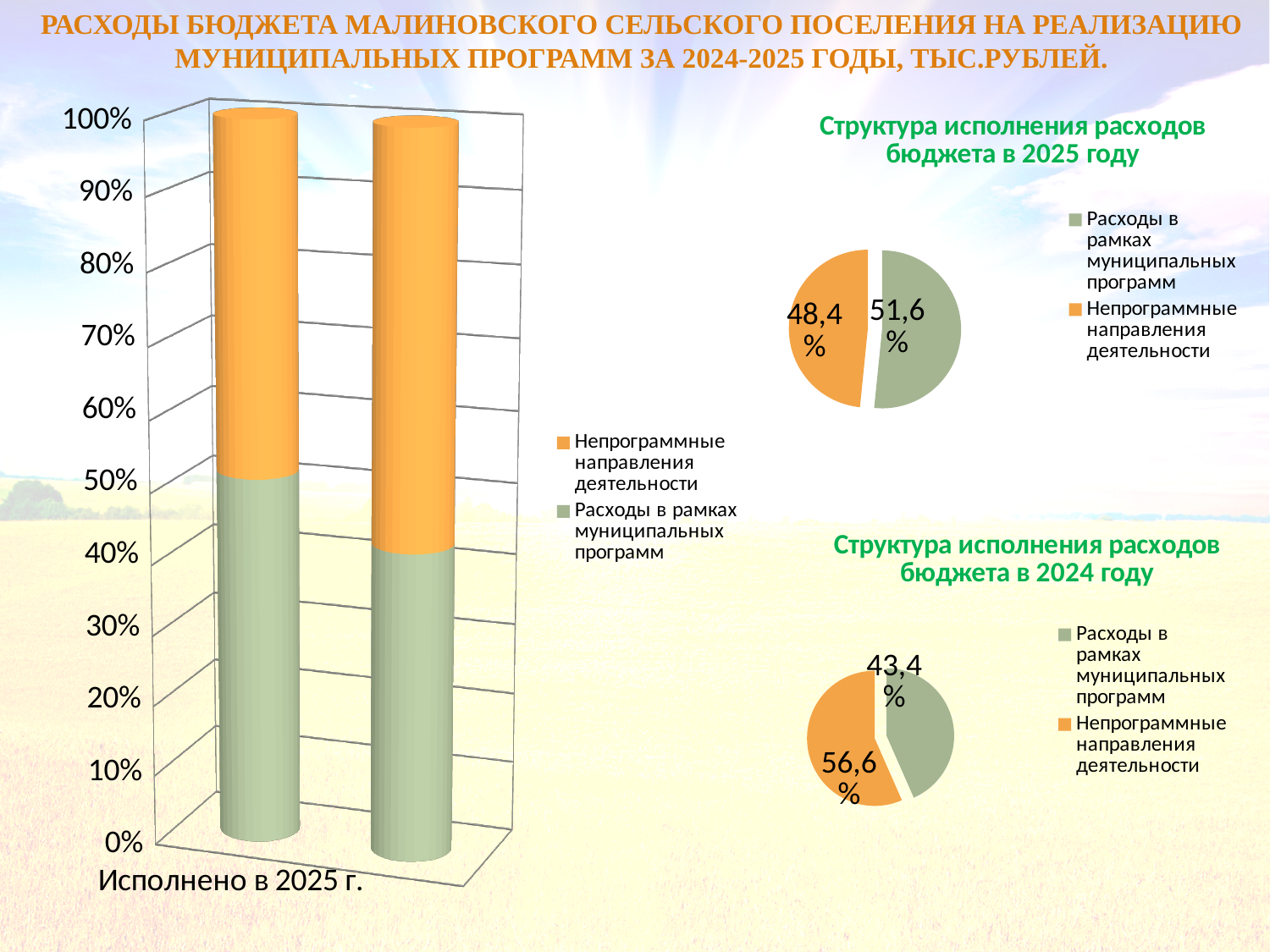
How many series does the legend of the bar chart on the left list? 2 In the pie chart titled 'Структура исполнения расходов бюджета в 2025 году', what is the difference between the two slices? 3,2% In the pie chart titled 'Структура исполнения расходов бюджета в 2024 году', which slice is larger: 'Расходы в рамках муниципальных программ' or 'Непрограммные направления деятельности'? Непрограммные направления деятельности In the pie chart titled 'Структура исполнения расходов бюджета в 2024 году', what share is shown for 'Расходы в рамках муниципальных программ'? 43,4% In the bar chart on the left, which colour represents 'Непрограммные направления деятельности'? Orange What kind of chart is the large chart on the left side of the slide? Bar chart In the pie chart titled 'Структура исполнения расходов бюджета в 2025 году', what share is shown for 'Непрограммные направления деятельности'? 48,4% In the pie chart titled 'Структура исполнения расходов бюджета в 2024 году', what share is shown for 'Непрограммные направления деятельности'? 56,6% In the pie chart titled 'Структура исполнения расходов бюджета в 2025 году', what share is shown for 'Расходы в рамках муниципальных программ'? 51,6% In the pie chart titled 'Структура исполнения расходов бюджета в 2025 году', which slice is the largest? Расходы в рамках муниципальных программ How many slices does the pie chart titled 'Структура исполнения расходов бюджета в 2024 году' have? 2 In the pie chart titled 'Структура исполнения расходов бюджета в 2024 году', what is the difference between the two slices? 13,2%